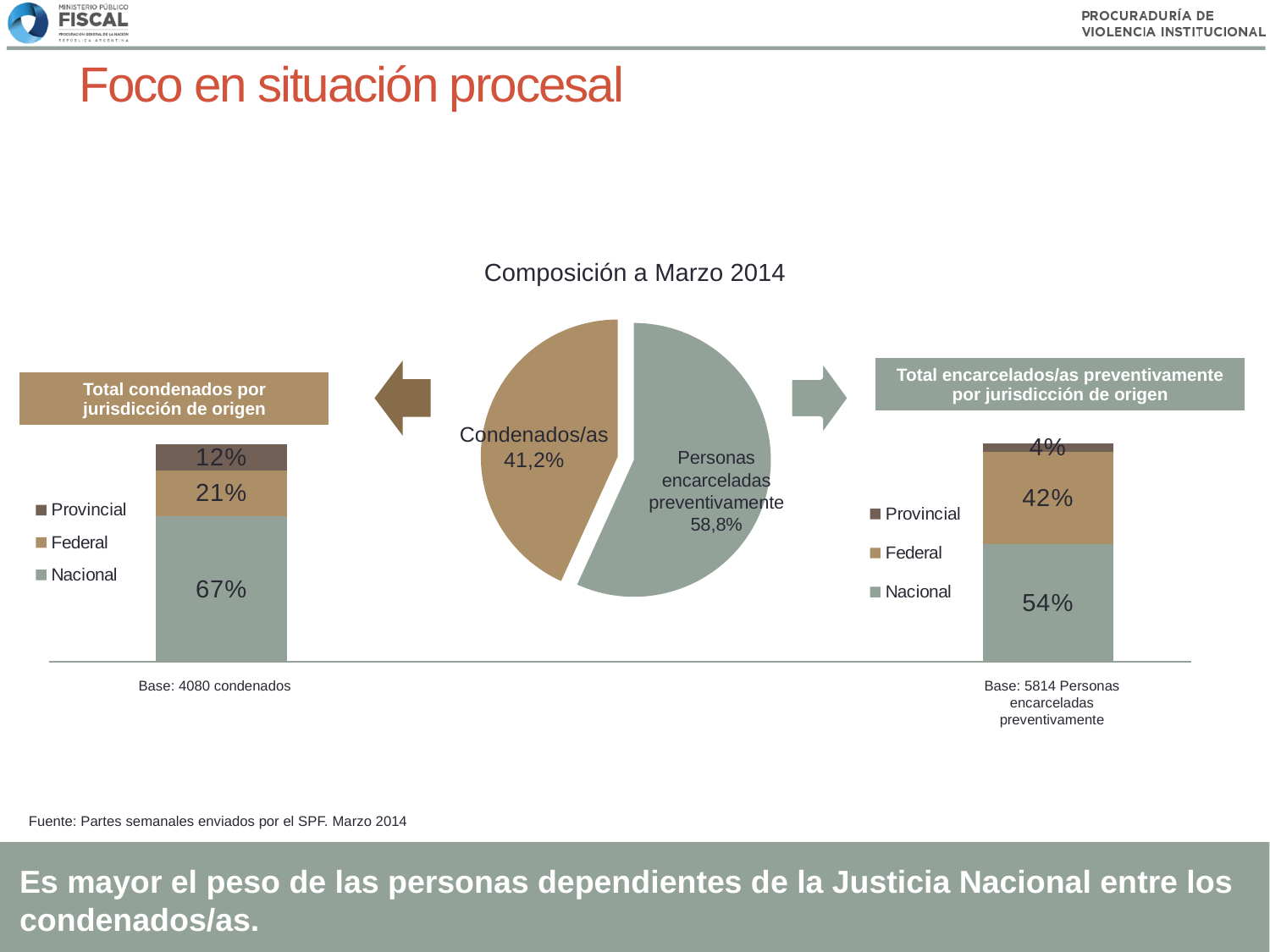
In the chart 'Total encarcelados/as preventivamente por jurisdicción de origen', what is the value for Provincial? 4% In the pie chart 'Composición a Marzo 2014', how many slices are there? 2 In the chart 'Total condenados por jurisdicción de origen', which jurisdiction has the lowest value? Provincial In the chart 'Total encarcelados/as preventivamente por jurisdicción de origen', which jurisdiction has the highest value? Nacional How many series does the legend of the chart 'Total encarcelados/as preventivamente por jurisdicción de origen' list? 3 In the pie chart 'Composición a Marzo 2014', what share is labelled for Condenados/as? 41,2% In the pie chart 'Composición a Marzo 2014', what share is labelled for Personas encarceladas preventivamente? 58,8% In the chart 'Total condenados por jurisdicción de origen', what is the value for Nacional? 67% In the chart 'Total condenados por jurisdicción de origen', what is the difference between the Nacional and Federal values? 46% In the chart 'Total condenados por jurisdicción de origen', what is the value for Federal? 21% In the pie chart 'Composición a Marzo 2014', which slice is larger, Condenados/as or Personas encarceladas preventivamente? Personas encarceladas preventivamente In the chart 'Total encarcelados/as preventivamente por jurisdicción de origen', what is the value for Federal? 42%